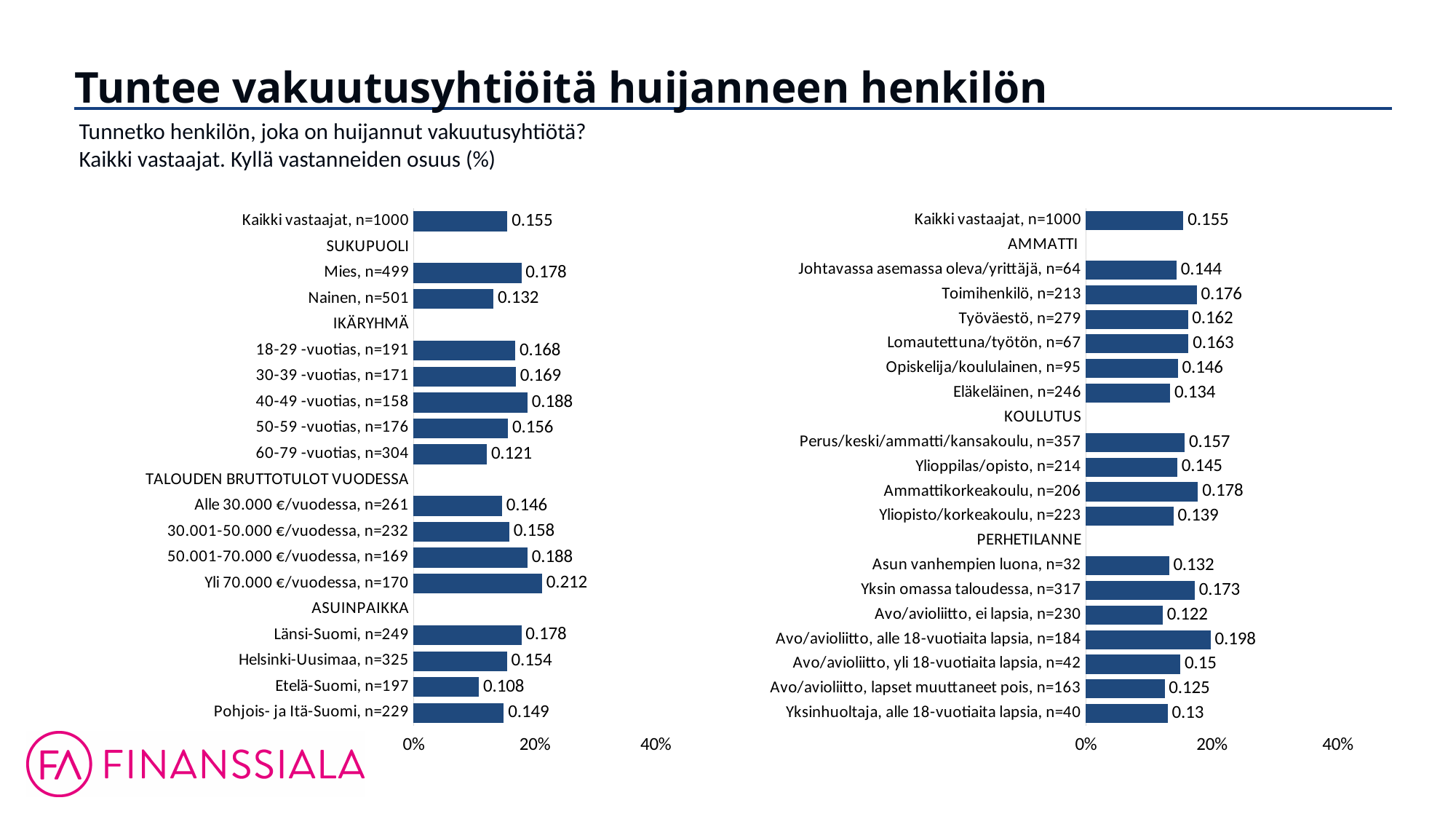
In the left chart, which category has the lowest value? Etelä-Suomi, n=197 In the right chart, what is the value for Eläkeläinen, n=246? 0.134 In the left chart, what is the value for Mies, n=499? 0.178 What type of chart is shown on the left of the slide? Bar chart In the right chart, which is larger: the value for Toimihenkilö, n=213 or Opiskelija/koululainen, n=95? Toimihenkilö, n=213 In the right chart, which category has the lowest value? Avo/avioliitto, ei lapsia, n=230 In the right chart, which category has the highest value? Avo/avioliitto, alle 18-vuotiaita lapsia, n=184 In the left chart, what is the value for Yli 70.000 €/vuodessa, n=170? 0.212 In the left chart, how many bars are plotted? 16 In the left chart, which category has the highest value? Yli 70.000 €/vuodessa, n=170 In the right chart, what is the value for Ammattikorkeakoulu, n=206? 0.178 In the left chart, what is the difference between the values for Mies, n=499 and Nainen, n=501? 0.046